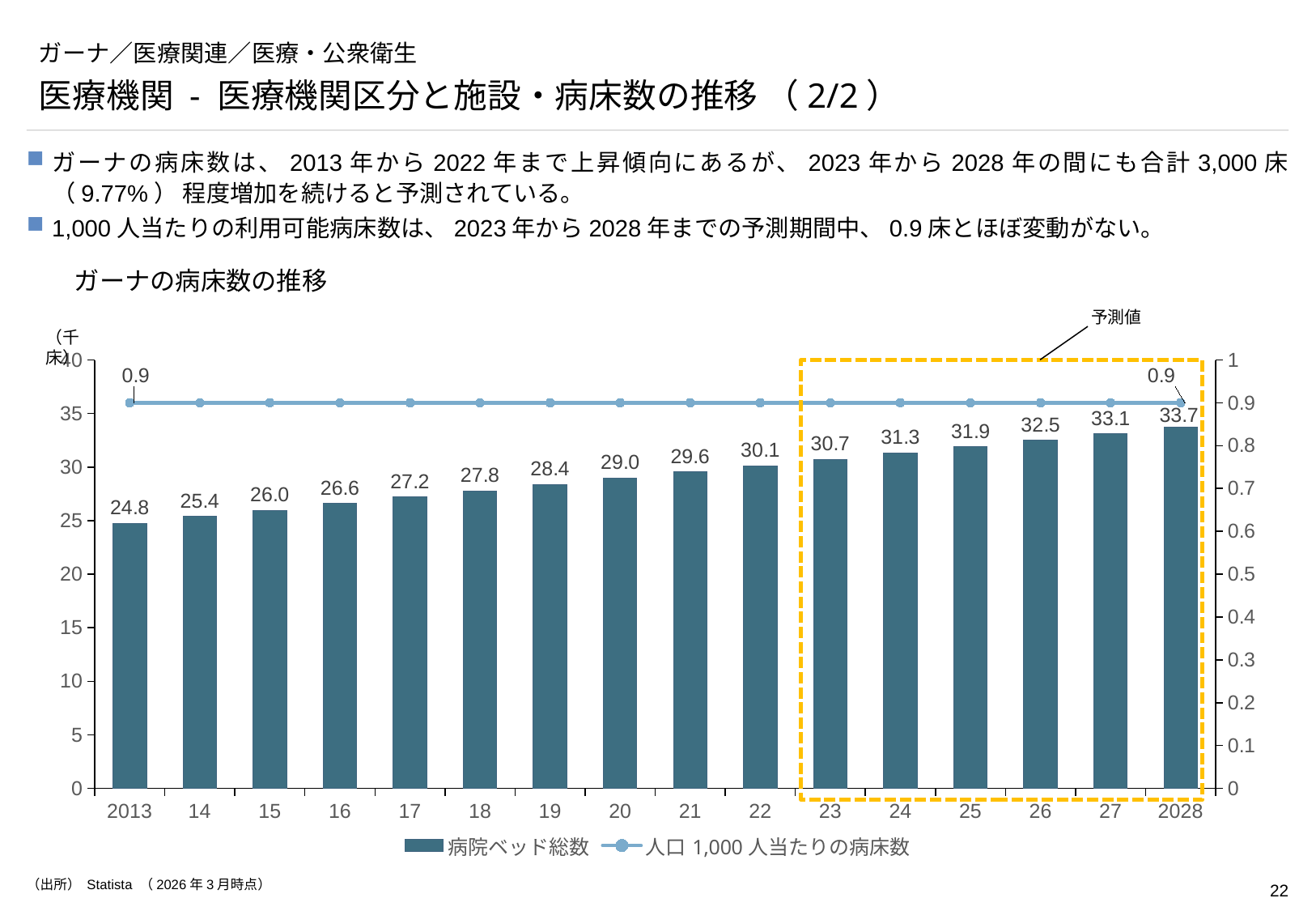
Which year has the lowest value of 病院ベッド総数? 2013 Do the values of 病院ベッド総数 rise or fall from 2013 to 2028? rise What kind of chart is used for 病院ベッド総数? bar chart What is the difference in 病院ベッド総数 between 2028 and 2013? 8.9 What is the value of 病院ベッド総数 for 2028? 33.7 What is the value of 病院ベッド総数 for 2013? 24.8 How many series does the legend list? 2 How many years are shown on the x axis? 16 What is the value of 人口1,000人当たりの病床数 for 2013? 0.9 Which is larger, the 病院ベッド総数 for 2018 or for 2024? 2024 Which year has the highest value of 病院ベッド総数? 2028 What is the value of 病院ベッド総数 for 2020? 29.0